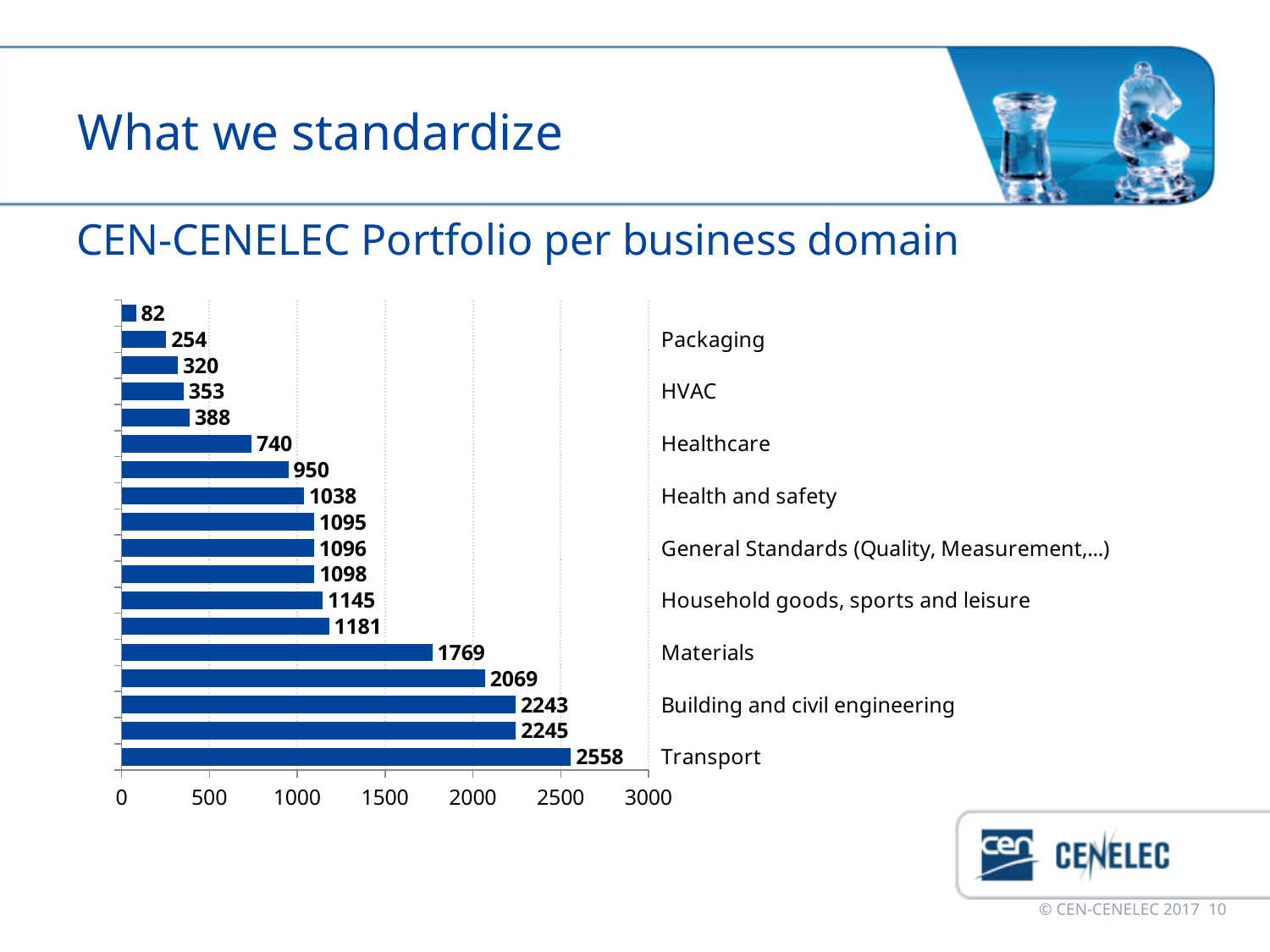
Is the value of the longest bar greater or less than 2500? greater How many bars have a value above 2000? 4 What is the value of the longest bar in the chart? 2558 What type of chart is shown on the slide? bar chart What is the value of the shortest bar in the chart? 82 What is the highest tick value shown on the horizontal axis? 3000 How many bars are plotted in the chart? 18 What is the value shown for Transport? 2558 What is the difference between the two longest bars, 2558 and 2245? 313 What is the title of the chart? CEN-CENELEC Portfolio per business domain What is the difference between the longest bar (2558) and the shortest bar (82)? 2476 Which is larger, the bar labelled 1769 or the bar labelled 2069? 2069